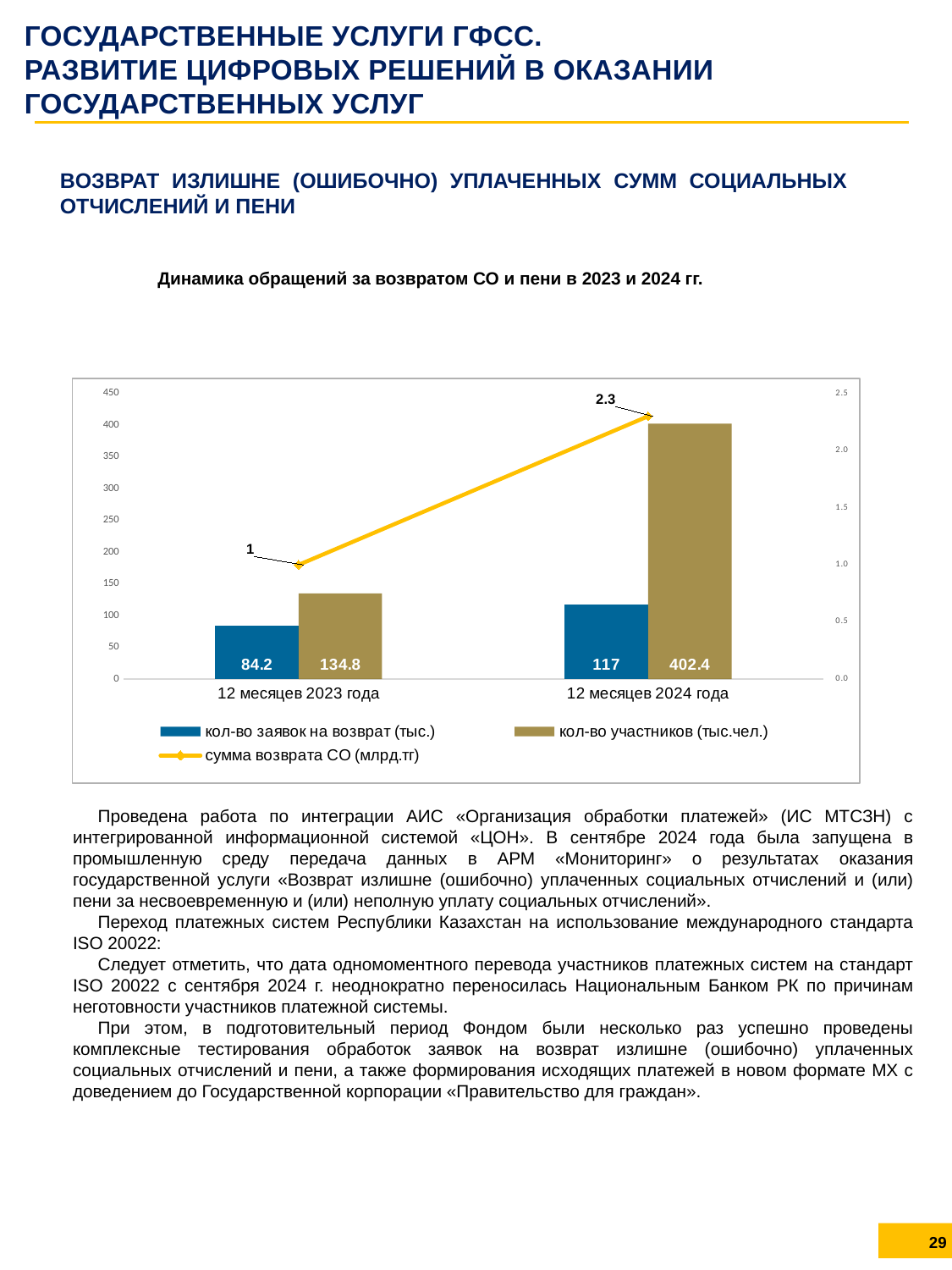
What is the title of the chart? Динамика обращений за возвратом СО и пени в 2023 и 2024 гг. What is the difference in 'кол-во участников (тыс.чел.)' between '12 месяцев 2024 года' and '12 месяцев 2023 года'? 267.6 What is the value of 'сумма возврата СО (млрд.тг)' for '12 месяцев 2023 года'? 1 How many categories are shown on the x axis of the chart? 2 What is the difference in 'кол-во заявок на возврат (тыс.)' between '12 месяцев 2024 года' and '12 месяцев 2023 года'? 32.8 Does 'сумма возврата СО (млрд.тг)' rise or fall from 2023 to 2024? rise How many series does the chart legend list? 3 Which period has the higher value of 'кол-во участников (тыс.чел.)'? 12 месяцев 2024 года What is the value of 'кол-во участников (тыс.чел.)' for '12 месяцев 2024 года'? 402.4 Which is larger for '12 месяцев 2023 года': 'кол-во заявок на возврат (тыс.)' or 'кол-во участников (тыс.чел.)'? кол-во участников (тыс.чел.) What is the value of 'сумма возврата СО (млрд.тг)' for '12 месяцев 2024 года'? 2.3 What is the value of 'кол-во заявок на возврат (тыс.)' for '12 месяцев 2023 года'? 84.2